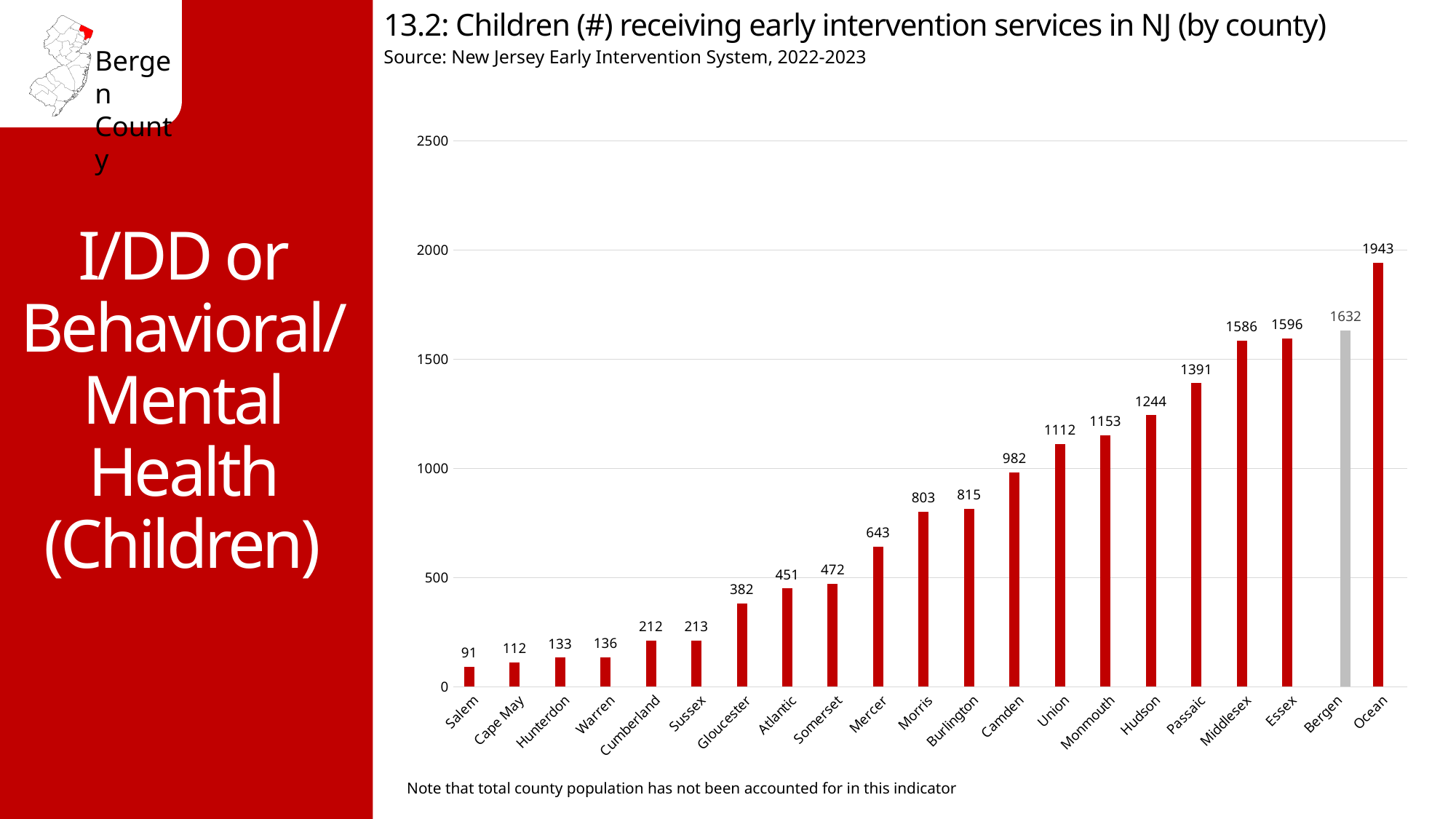
Which has a larger value, Hudson or Camden? Hudson What is the difference between the values for Essex and Middlesex? 10 Which county has the lowest number of children receiving early intervention services? Salem What is the difference between the values for Ocean and Bergen? 311 Which county has the highest number of children receiving early intervention services? Ocean How many children are receiving early intervention services in Bergen County? 1632 Which county's bar is shown in grey rather than red? Bergen How many counties are shown on the chart? 21 Do the values rise or fall moving from left to right along the x axis? Rise Is the value for Passaic greater or less than 1500? less What is the value shown for Mercer? 643 What kind of chart is shown on the slide? Bar chart